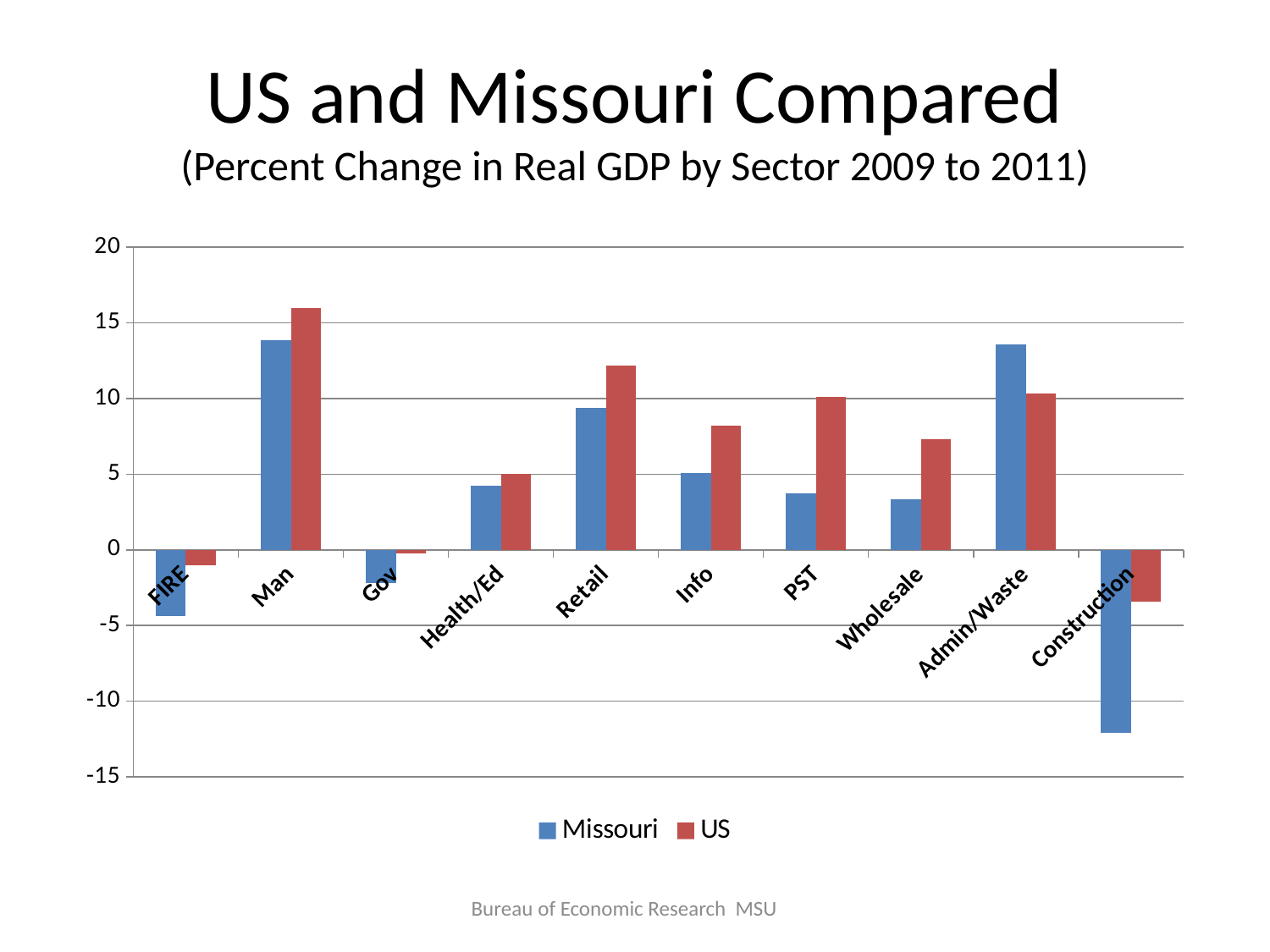
How many series does the legend list? 2 For Admin/Waste, which is larger, the Missouri value or the US value? Missouri Which sector has the lowest Missouri value? Construction For PST, which is larger, the Missouri value or the US value? US Which sector has the lowest US value? Construction Is the US value for Retail greater or less than 10? greater Is the US value for Man greater or less than 15? greater How many sectors are shown on the x axis of the chart? 10 Which sector has the highest US value? Man Is the Missouri value for Construction greater or less than -10? less What kind of chart is shown on the slide? bar chart Which series is shown in blue in the chart? Missouri